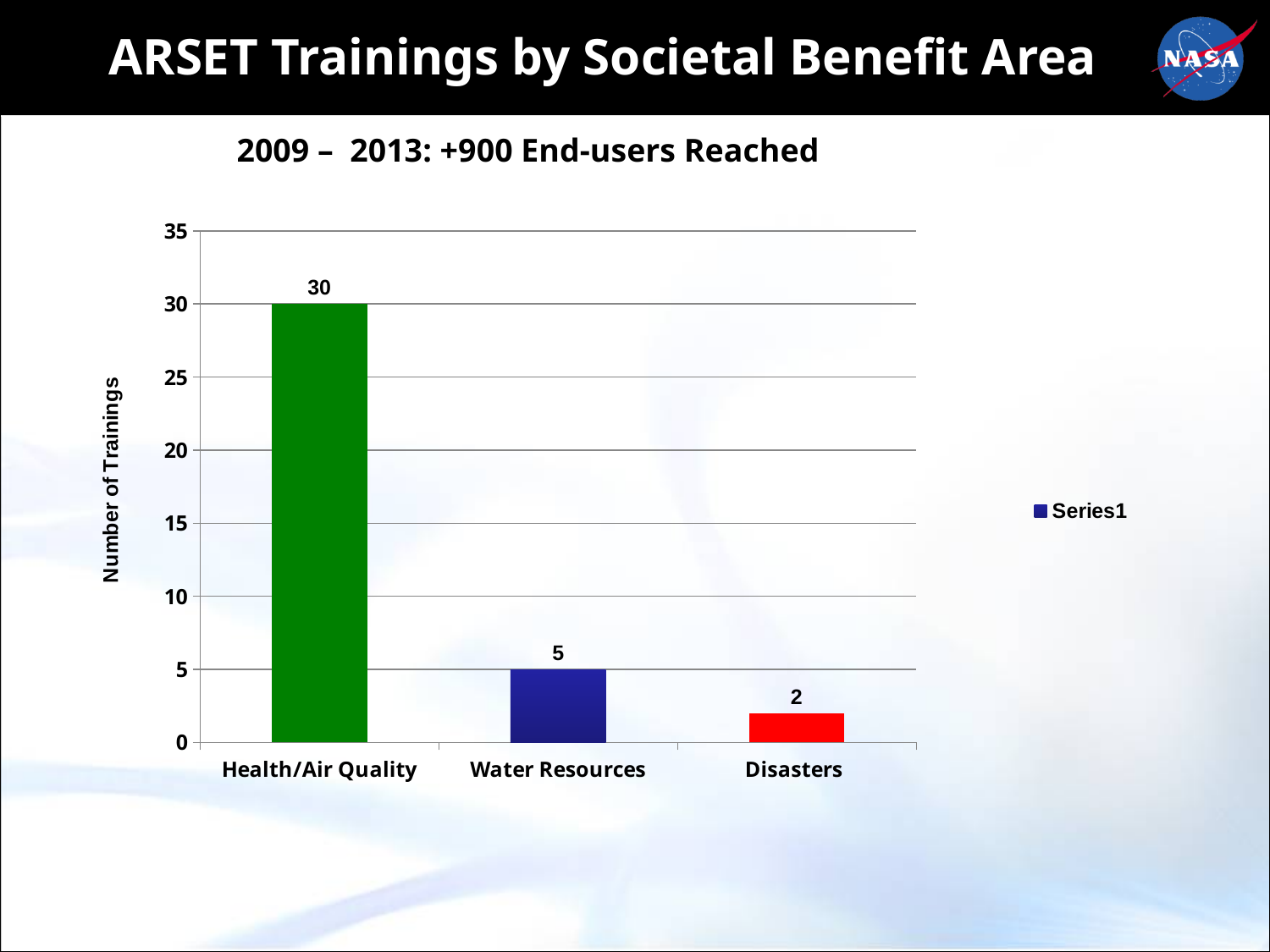
What is the number of trainings for Disasters? 2 What is the difference in number of trainings between Water Resources and Disasters? 3 What kind of chart is shown on the slide? bar chart What is the label of the y axis? Number of Trainings How many societal benefit areas are shown on the x axis? 3 What is the number of trainings for Water Resources? 5 Which societal benefit area has the highest number of trainings? Health/Air Quality Which has more trainings, Water Resources or Disasters? Water Resources What is the difference in number of trainings between Health/Air Quality and Water Resources? 25 What is the number of trainings for Health/Air Quality? 30 Which societal benefit area has the lowest number of trainings? Disasters Is the value for Health/Air Quality greater or less than 25? greater